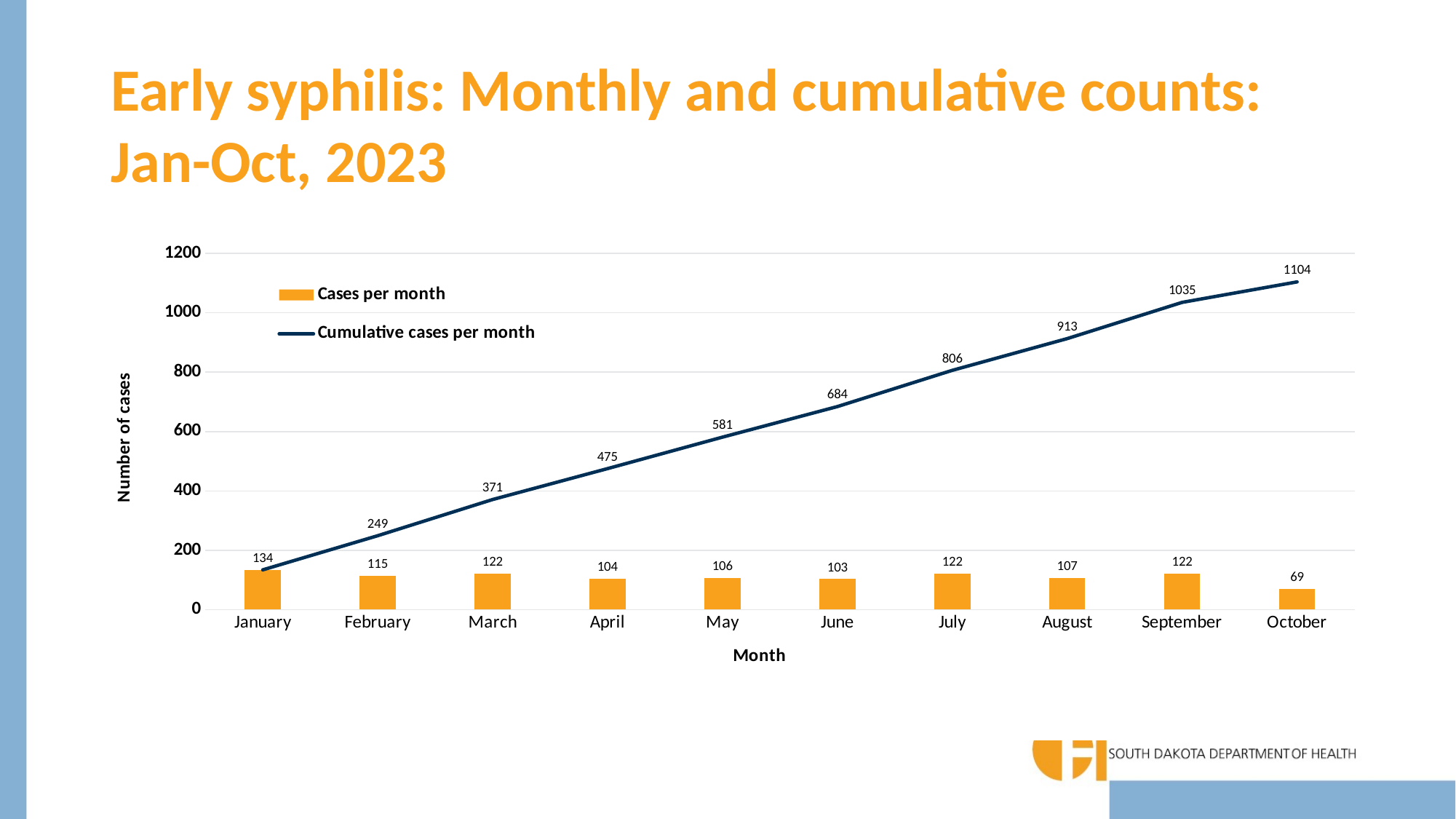
What is the difference between the cases per month in January and October? 65 Which is larger, the cases per month in April or in August? August What is the label of the y axis? Number of cases Which month has the highest cases per month? January Is the cumulative cases per month value for July greater or less than 800? greater Which month has the lowest cases per month? October Does the cumulative cases per month line rise or fall from January to October? rise How many cases per month were reported in January? 134 How many months are shown on the x axis? 10 What is the cumulative cases per month value for June? 684 What is the cumulative cases per month value for October? 1104 How many series does the legend list? 2